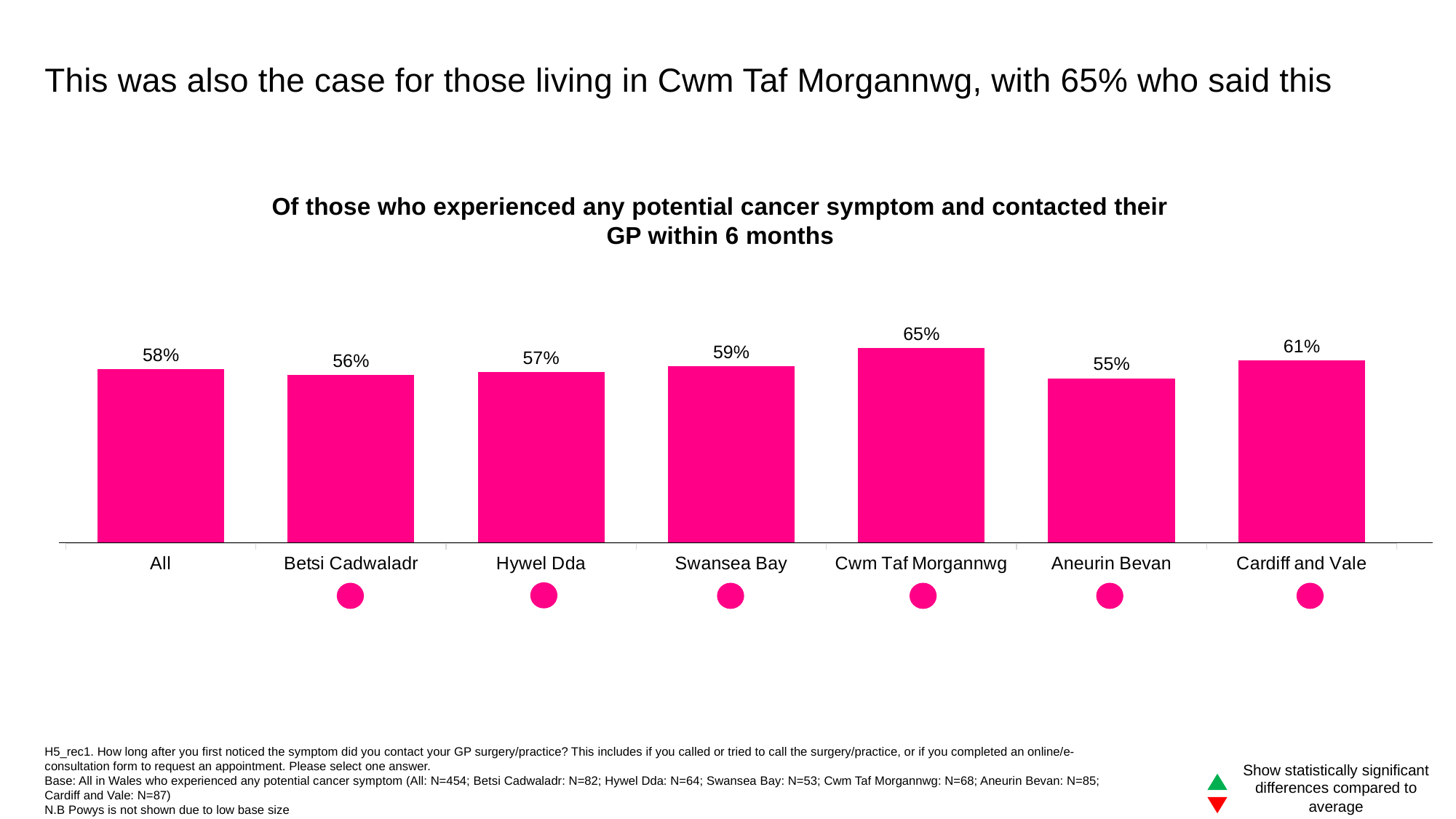
Which category has the highest value? Cwm Taf Morgannwg What is the difference between the values for Cwm Taf Morgannwg and Aneurin Bevan? 10% What kind of chart is shown on the slide? Bar chart Which category has the lowest value? Aneurin Bevan What is the title of the chart? Of those who experienced any potential cancer symptom and contacted their GP within 6 months How many categories are shown on the chart? 7 What is the value for Cardiff and Vale? 61% What is the value for the All category? 58% What is the value for Aneurin Bevan? 55% Which is larger, the value for Swansea Bay or the value for Hywel Dda? Swansea Bay What is the difference between the values for Cardiff and Vale and Betsi Cadwaladr? 5% What is the value for Cwm Taf Morgannwg? 65%